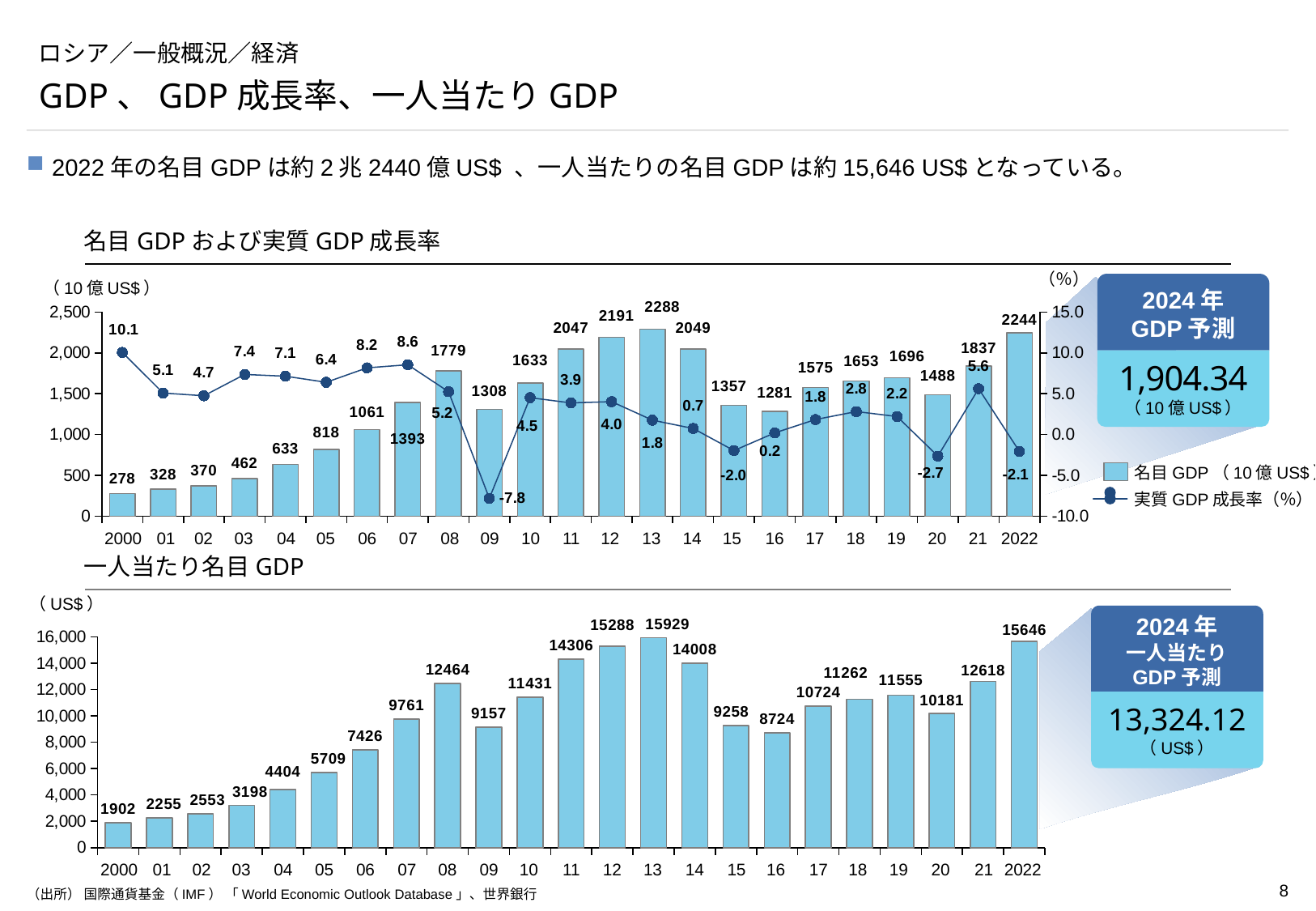
In the bottom chart (一人当たり名目GDP), which year has the larger value, 2008 or 2009? 2008 How many years are plotted in the bottom chart (一人当たり名目GDP)? 23 In the bottom chart (一人当たり名目GDP), which year has the highest value? 2013 In the top chart (名目GDPおよび実質GDP成長率), what is the nominal GDP value for 2013? 2288 In the top chart (名目GDPおよび実質GDP成長率), what is the difference in nominal GDP between 2022 and 2021? 407 How many series does the legend of the top chart (名目GDPおよび実質GDP成長率) list? 2 What kind of chart is the bottom chart (一人当たり名目GDP)? bar chart In the top chart (名目GDPおよび実質GDP成長率), which year has the lowest real GDP growth rate? 2009 In the top chart (名目GDPおよび実質GDP成長率), what is the real GDP growth rate for 2009? -7.8 In the bottom chart (一人当たり名目GDP), what is the value for 2022? 15646 In the bottom chart (一人当たり名目GDP), which year has the lowest value? 2000 In the top chart (名目GDPおよび実質GDP成長率), which year has the highest nominal GDP? 2013